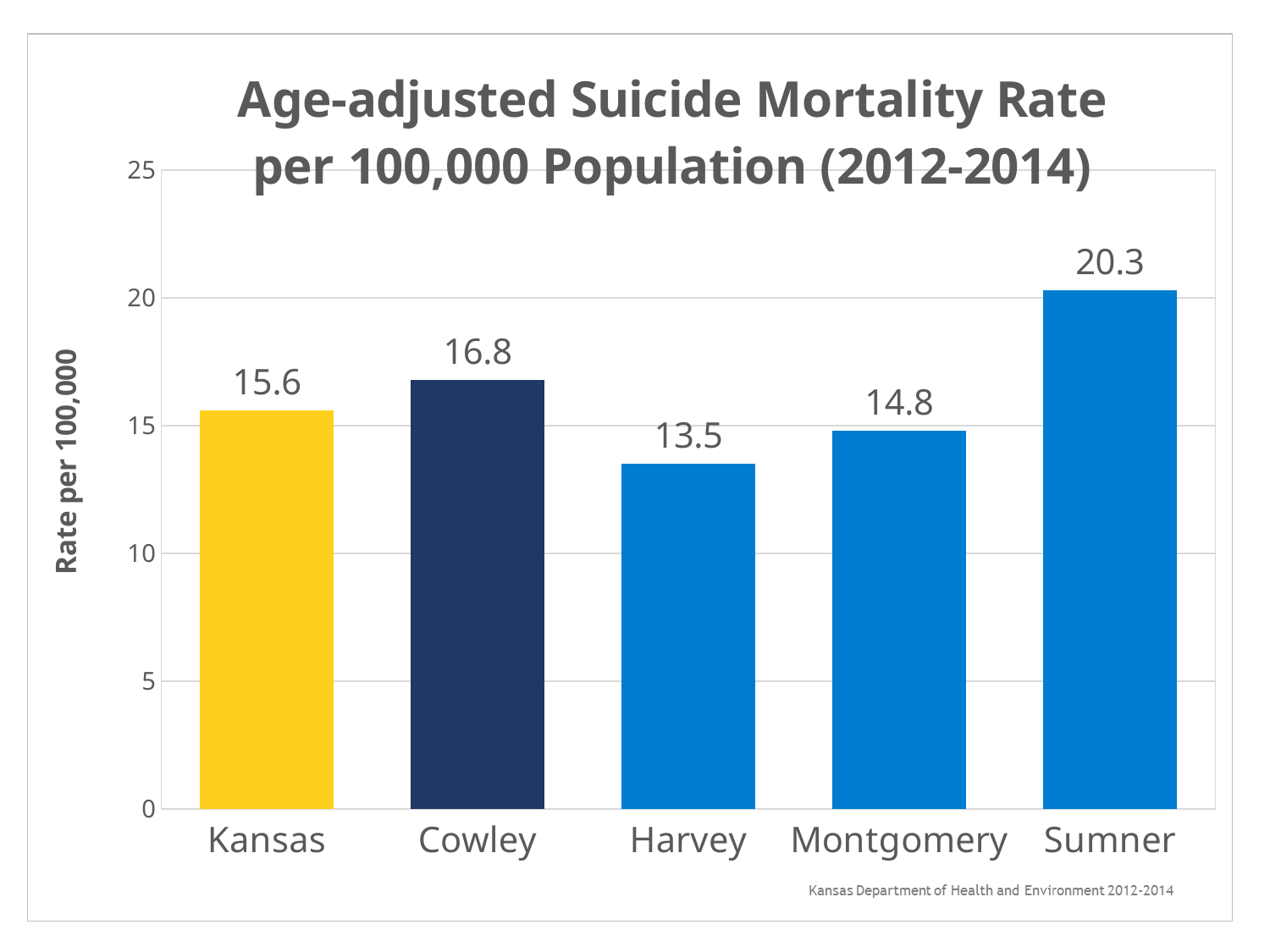
Which category has the lowest age-adjusted suicide mortality rate? Harvey How many categories are shown on the x axis? 5 Is the value for Sumner greater or less than 20? greater Which has a higher rate, Montgomery or Kansas? Kansas What is the age-adjusted suicide mortality rate for Kansas? 15.6 Which category has the highest age-adjusted suicide mortality rate? Sumner What is the difference between the rates for Cowley and Kansas? 1.2 What kind of chart is shown on the slide? Bar chart What is the age-adjusted suicide mortality rate for Cowley? 16.8 What is the age-adjusted suicide mortality rate for Montgomery? 14.8 What is the difference between the rates for Sumner and Harvey? 6.8 What is the label on the vertical axis? Rate per 100,000